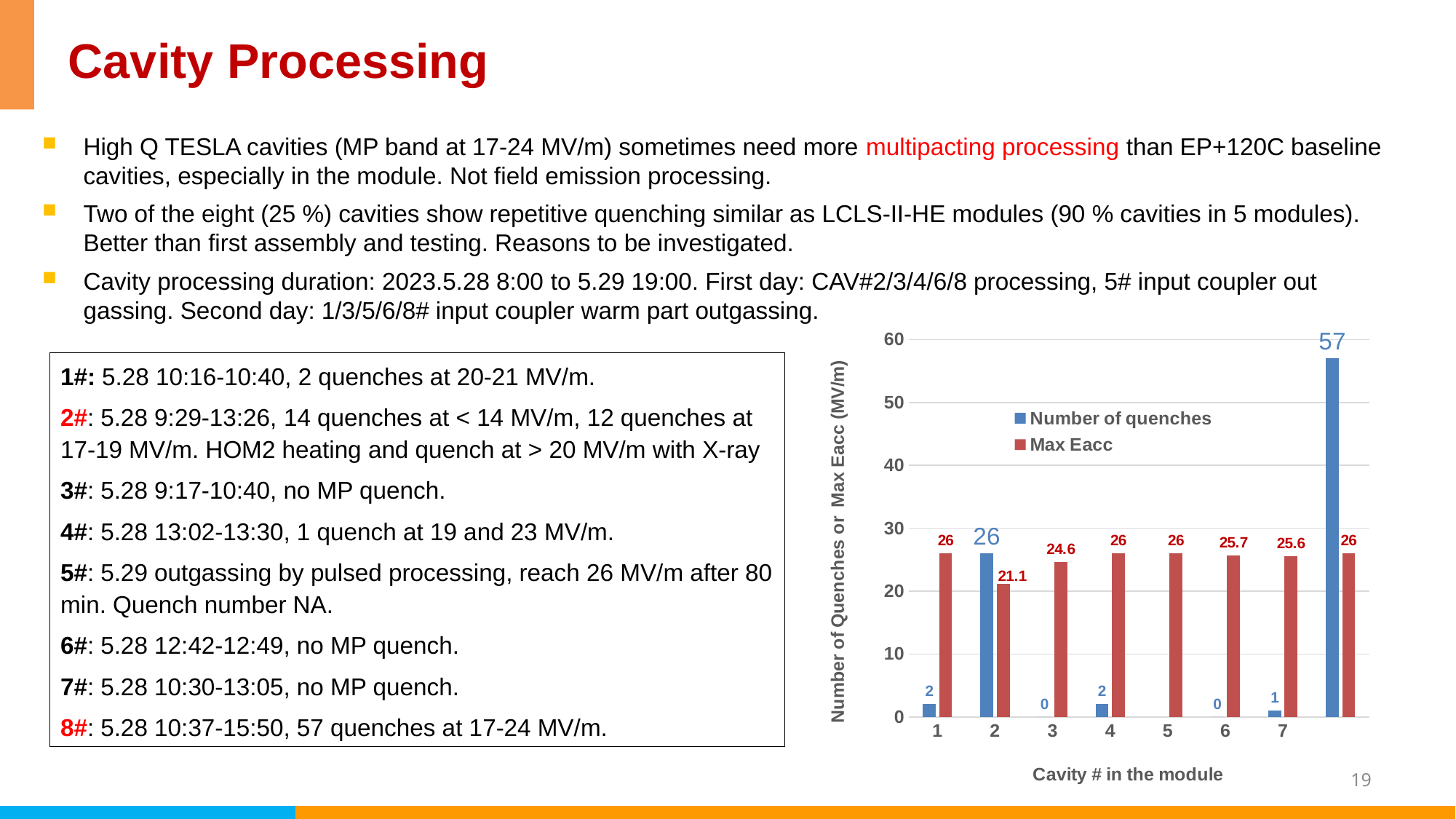
Is the Number of quenches for cavity 2 greater or less than 20? greater What is the difference between the Max Eacc values for cavity 1 and cavity 2? 4.9 Which has a higher Max Eacc value, cavity 6 or cavity 7? Cavity 6 What is the Max Eacc value for cavity 6? 25.7 Which cavity has the lowest Max Eacc value? 2 What is the Max Eacc value for cavity 3? 24.6 What is the Max Eacc value for cavity 2? 21.1 How many series does the chart legend list? 2 What is the highest Number of quenches value shown in the chart? 57 What is the Number of quenches for cavity 2? 26 What is the Number of quenches for cavity 7? 1 What kind of chart is shown on the slide? Bar chart